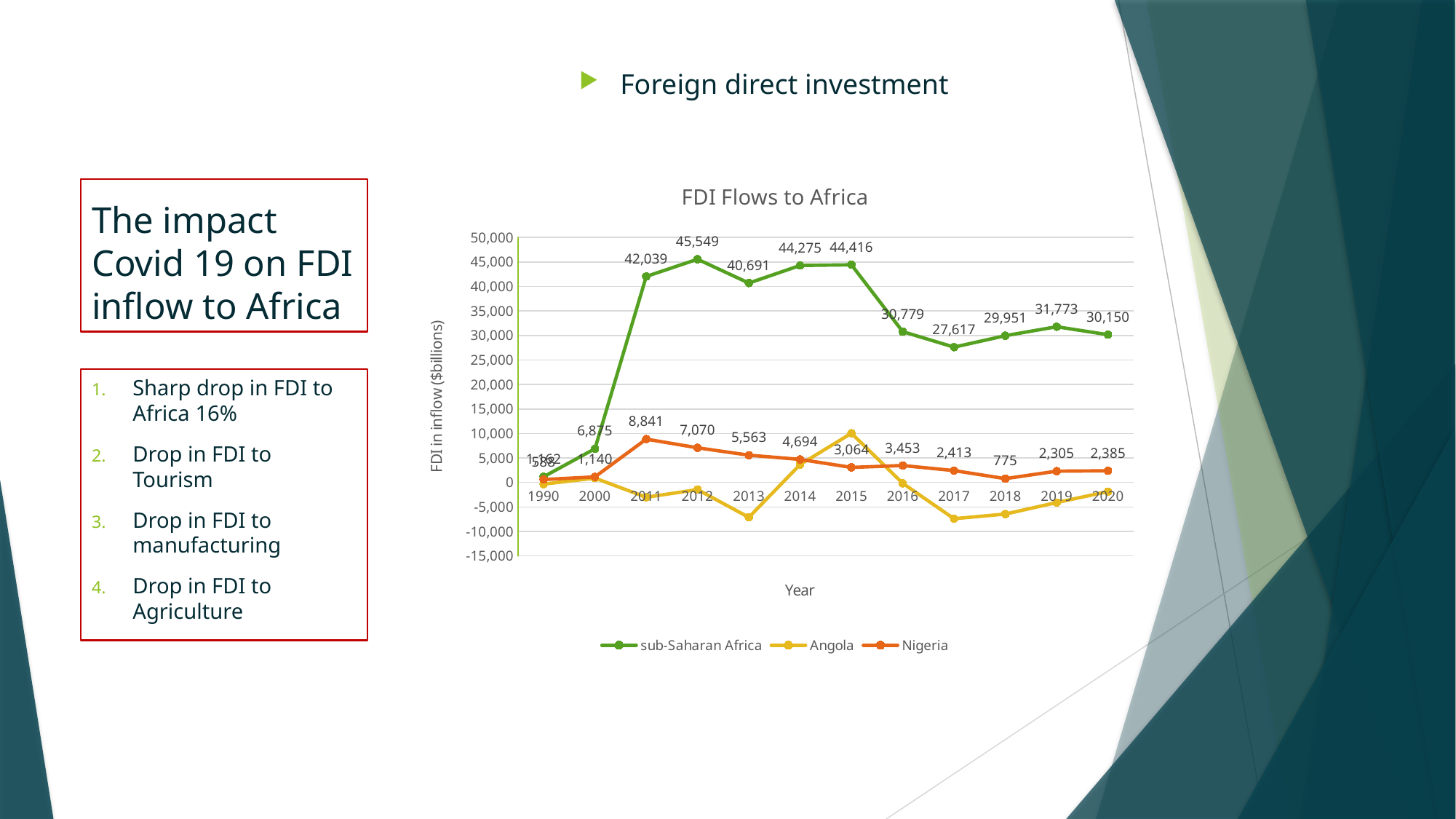
How many series does the legend of the FDI Flows to Africa chart list? 3 What kind of chart is shown on the slide? line chart What is the value for Nigeria in 2011? 8,841 What is the value for sub-Saharan Africa in 2017? 27,617 In which year is the sub-Saharan Africa series at its highest? 2012 What is the title of the chart? FDI Flows to Africa What is the difference between the sub-Saharan Africa values for 2019 and 2020? 1,623 Which is larger for Nigeria: the value in 2016 or the value in 2017? 2016 In which year is the Nigeria series at its highest? 2011 What is the value for sub-Saharan Africa in 2012? 45,549 Is the value for Angola in 2015 greater or less than 5,000? greater How many years are plotted along the x axis of the FDI Flows to Africa chart? 12